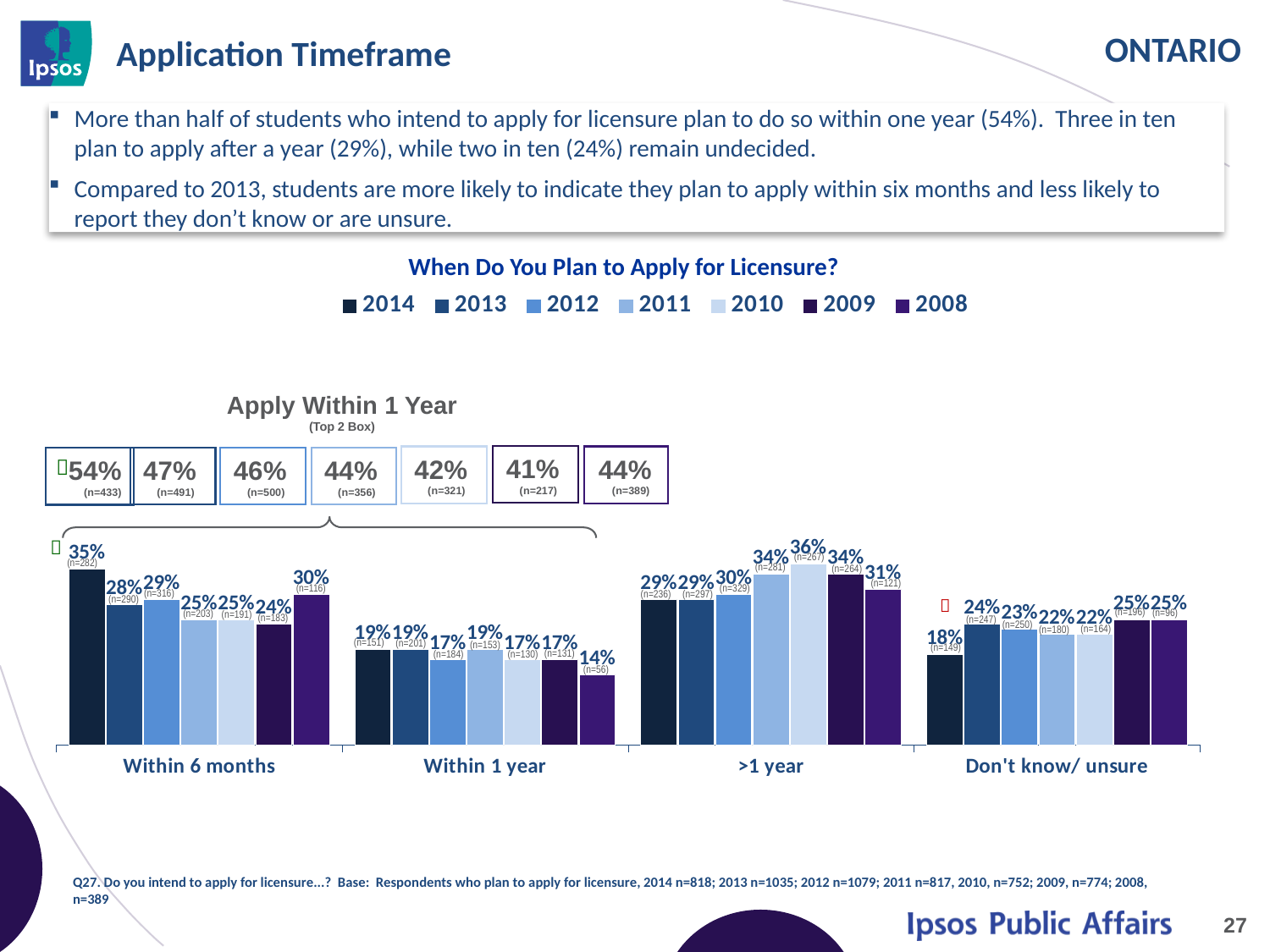
How many series does the legend list? 7 What is the difference between the 2014 and 2013 values for "Within 6 months"? 7% Which is larger for ">1 year": the 2010 value or the 2014 value? 2010 Which year has the lowest value for "Within 1 year"? 2008 What is the "Apply Within 1 Year (Top 2 Box)" value for 2014? 54% What is the 2008 value for "Within 1 year"? 14% What is the 2014 value for "Within 6 months"? 35% What kind of chart is shown? Bar chart How many categories are shown on the x axis? 4 Which year has the highest value for "Within 6 months"? 2014 What is the 2010 value for ">1 year"? 36% What is the 2014 value for "Don't know/ unsure"? 18%